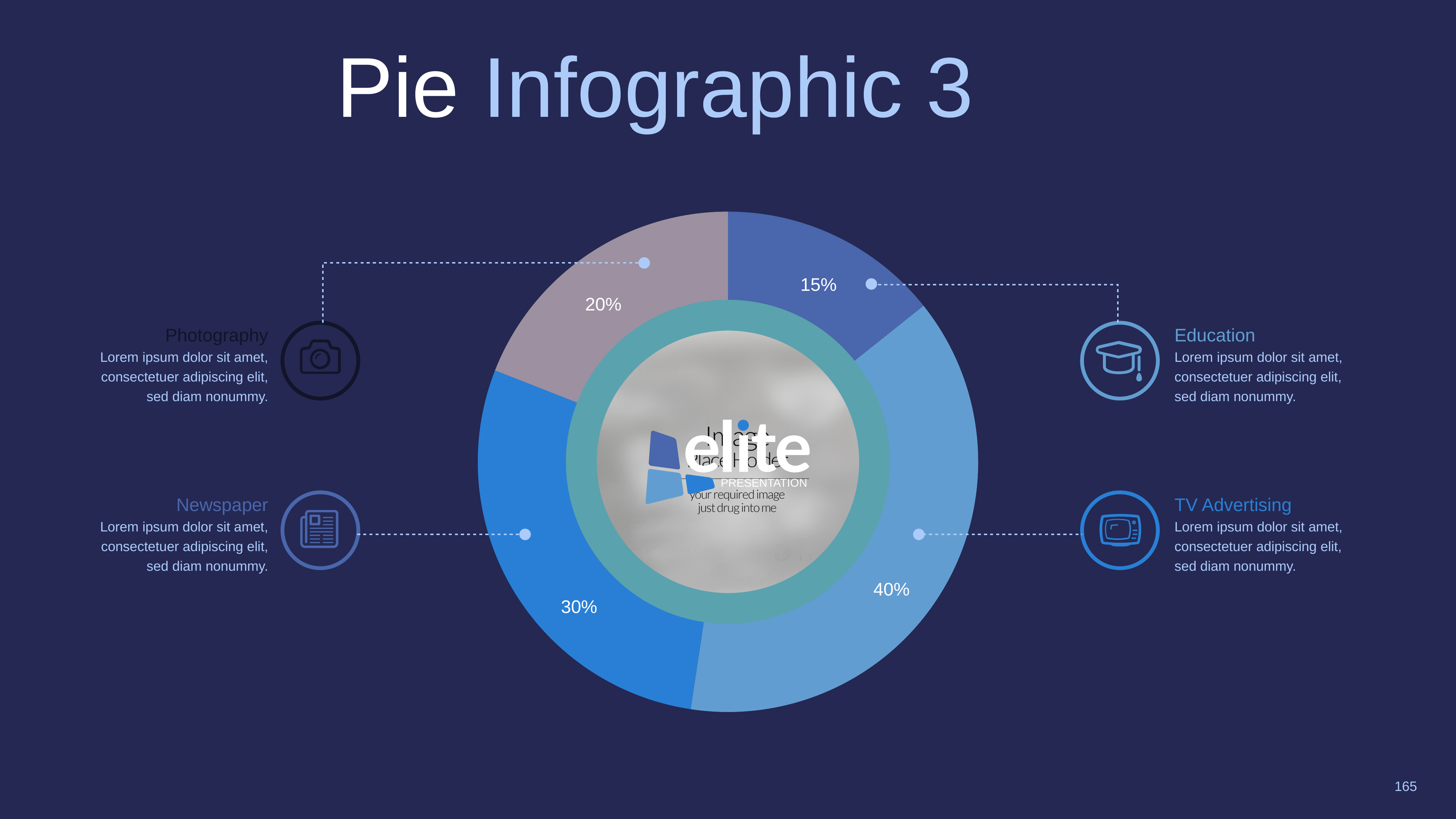
What kind of chart is shown on the slide? Pie chart How many slices does the pie chart have? 4 What share of the pie does the TV Advertising slice represent? 40% What is the difference in percentage points between the Photography slice and the Education slice? 5 What is the difference in percentage points between the TV Advertising slice and the Newspaper slice? 10 What is the title of the slide containing the pie chart? Pie Infographic 3 Which slice is larger, Newspaper or Photography? Newspaper Which category has the largest slice of the pie? TV Advertising What share of the pie does the Education slice represent? 15% What share of the pie does the Newspaper slice represent? 30% Which category has the smallest slice of the pie? Education What share of the pie does the Photography slice represent? 20%